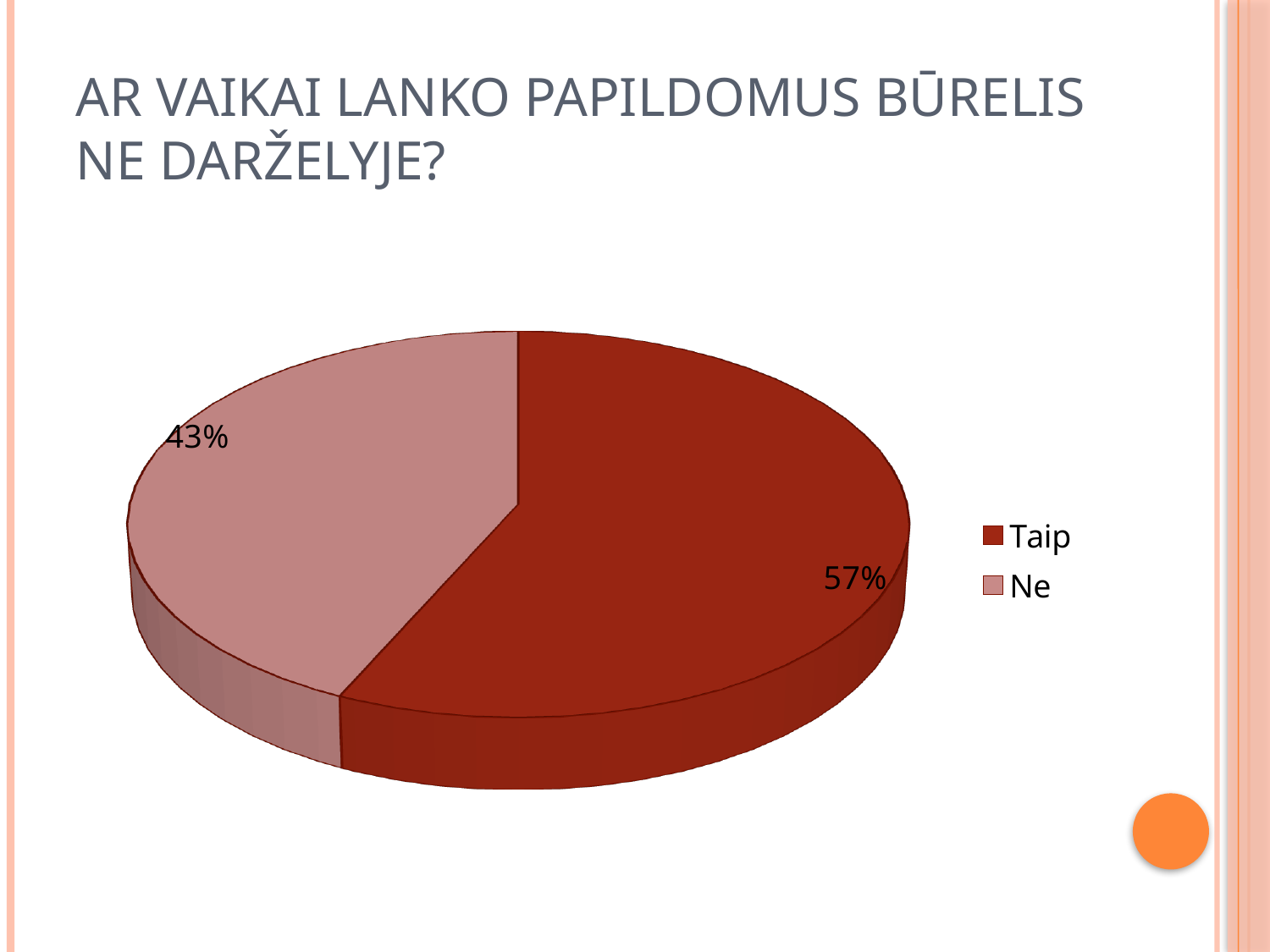
What percentage of the pie is labelled for "Taip"? 57% Which slice of the pie is the smallest? Ne How many slices does the pie chart have? 2 What is the difference in percentage points between the "Taip" and "Ne" slices? 14 Which is larger, the "Taip" slice or the "Ne" slice? Taip What kind of chart is shown on the slide? pie chart How many entries does the legend list? 2 What colour is the "Taip" slice in the pie chart? dark red What is the title of the slide containing the pie chart? AR VAIKAI LANKO PAPILDOMUS BŪRELIS NE DARŽELYJE? What share of the pie does the "Ne" slice represent? 43% What percentage of the pie is labelled for "Ne"? 43% Which slice of the pie is the largest? Taip